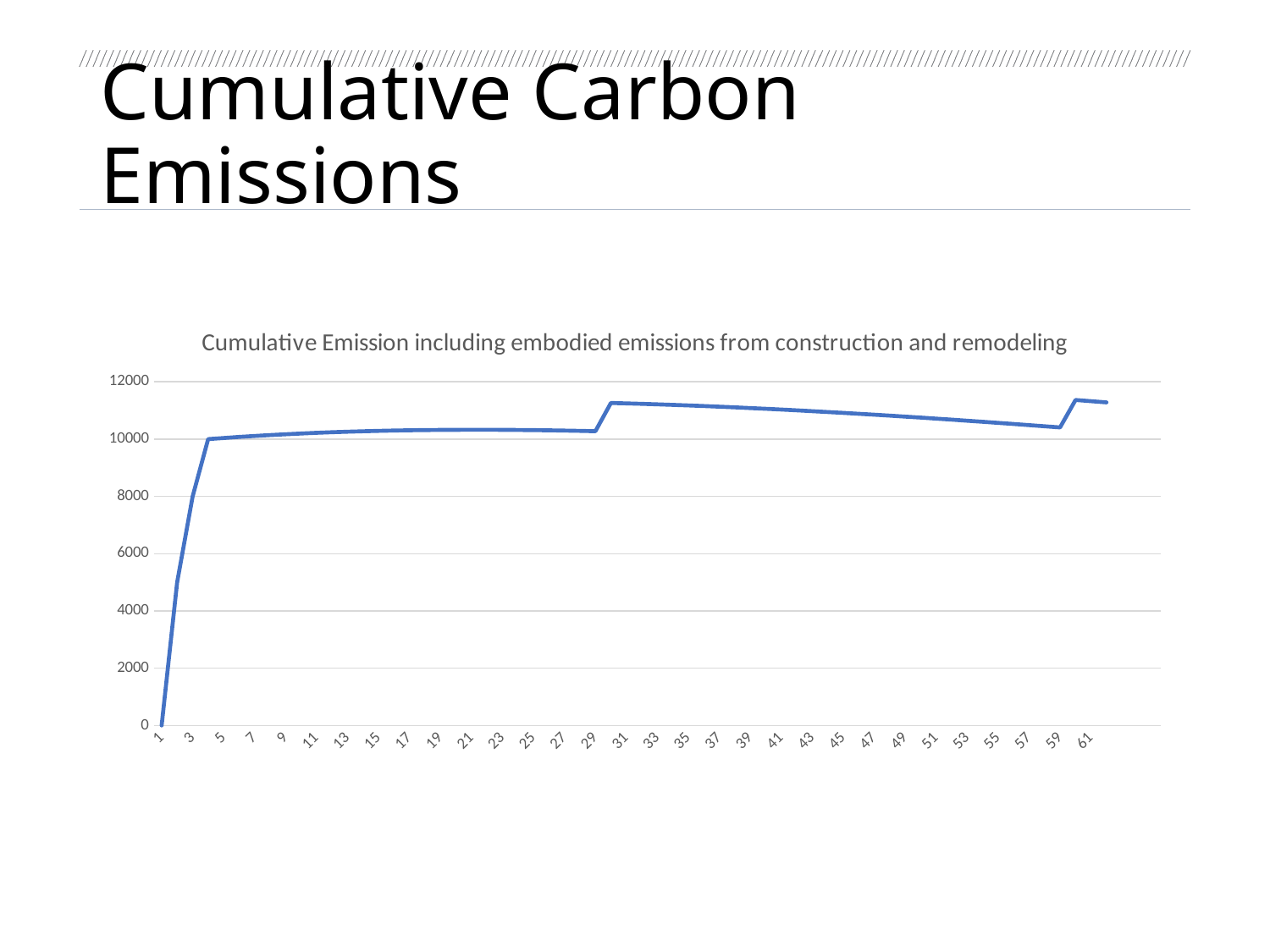
What is the highest value shown on the y axis? 12000 Is the value at x = 5 greater or less than 8000? greater What kind of chart is shown on the slide? line chart Is the value at x = 2 greater or less than 6000? less Is the value at x = 61 greater or less than 10000? greater What is the title of the chart? Cumulative Emission including embodied emissions from construction and remodeling Which is larger, the value at x = 31 or the value at x = 59? x = 31 Overall, do the values rise or fall from the start to the end of the x axis? rise Which is larger, the value at x = 5 or the value at x = 31? x = 31 What is the value at x = 1? 0